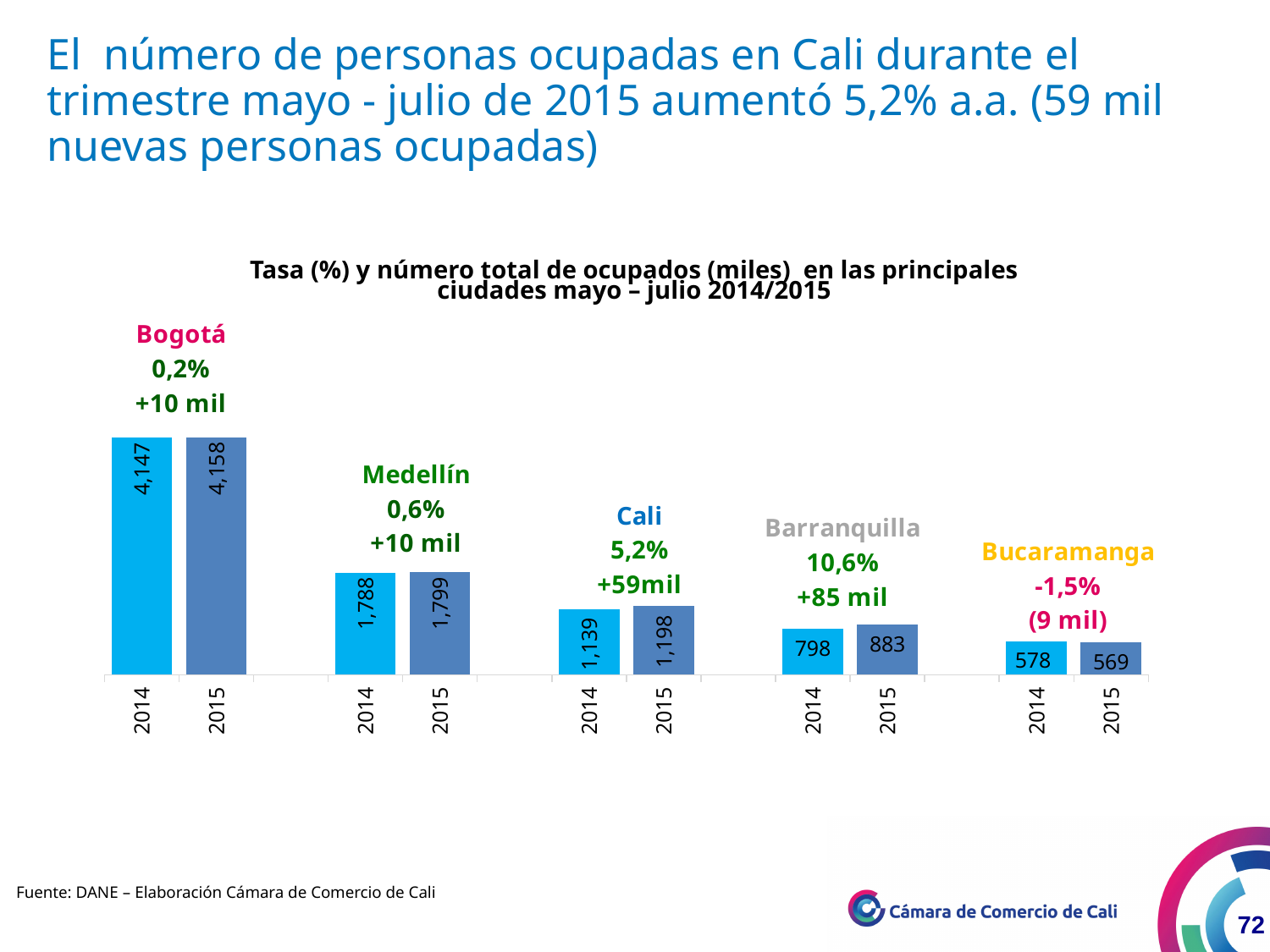
What is the value shown for Bucaramanga in 2014? 578 Which city has the highest number of employed persons in 2015? Bogotá What type of chart is shown on the slide? Bar chart What growth rate is shown for Barranquilla? 10,6% What is the difference between Cali's 2015 and 2014 values? 59 What is the difference between Barranquilla's 2015 and 2014 values? 85 How many cities are shown in the chart? 5 What is the value shown for Barranquilla in 2015? 883 Which city has the lowest number of employed persons in 2014? Bucaramanga Which is larger, Medellín's 2015 value or Cali's 2015 value? Medellín's 2015 value What is the number of employed persons (thousands) in Bogotá in 2014? 4,147 What is the number of employed persons (thousands) in Cali in 2015? 1,198